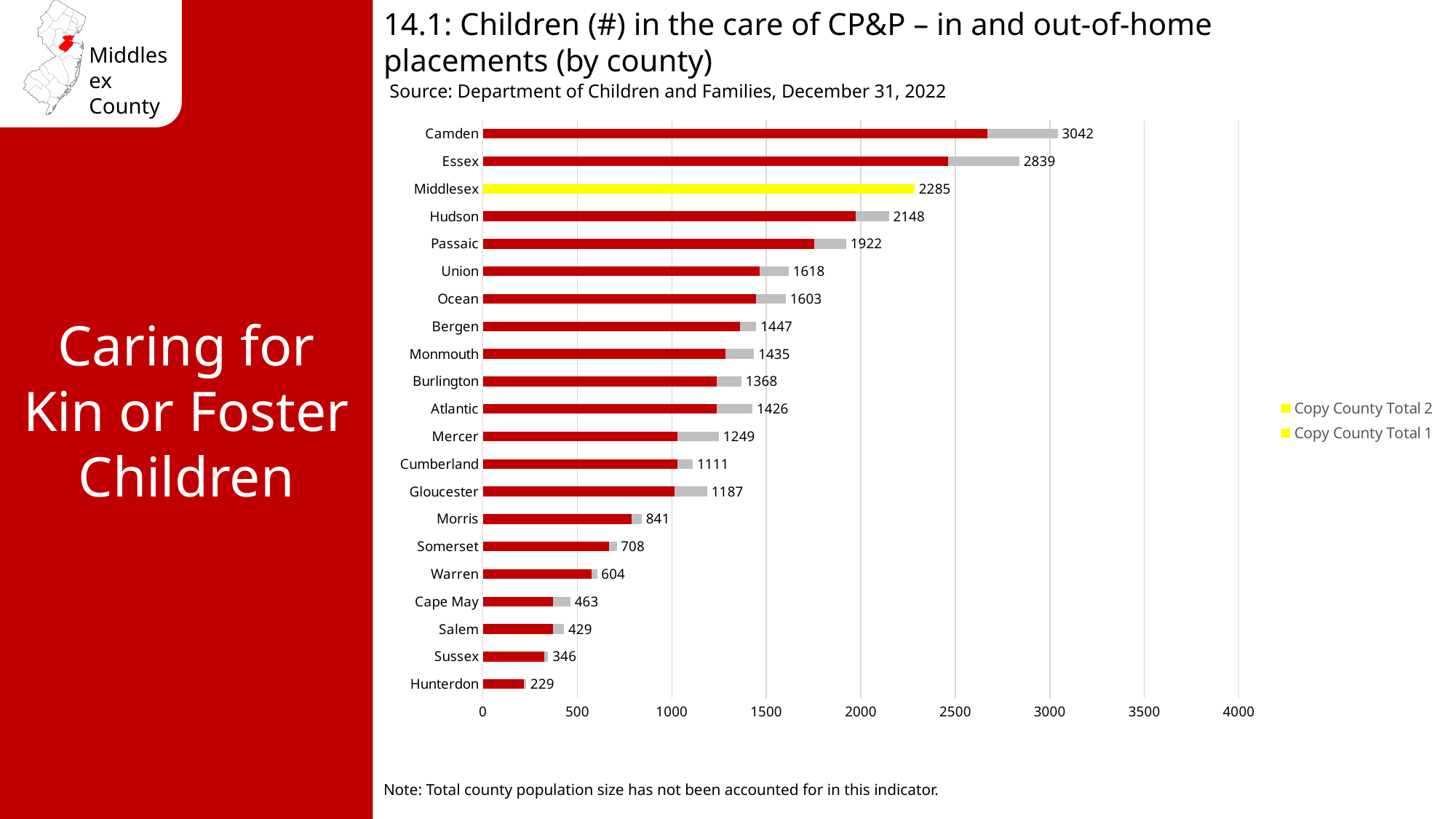
Which county has the highest total? Camden What kind of chart is shown on the slide? Bar chart Which has a larger total, Atlantic or Burlington? Atlantic What value is labelled for Hunterdon? 229 Is the value for Morris greater or less than 1000? less What is the difference between the totals for Camden and Essex? 203 What value is labelled for Passaic? 1922 How many series does the legend list? 2 How many counties are shown in the chart? 21 Which county has the lowest total? Hunterdon What value is labelled for Camden? 3042 What is the total number of children in the care of CP&P shown for Middlesex? 2285